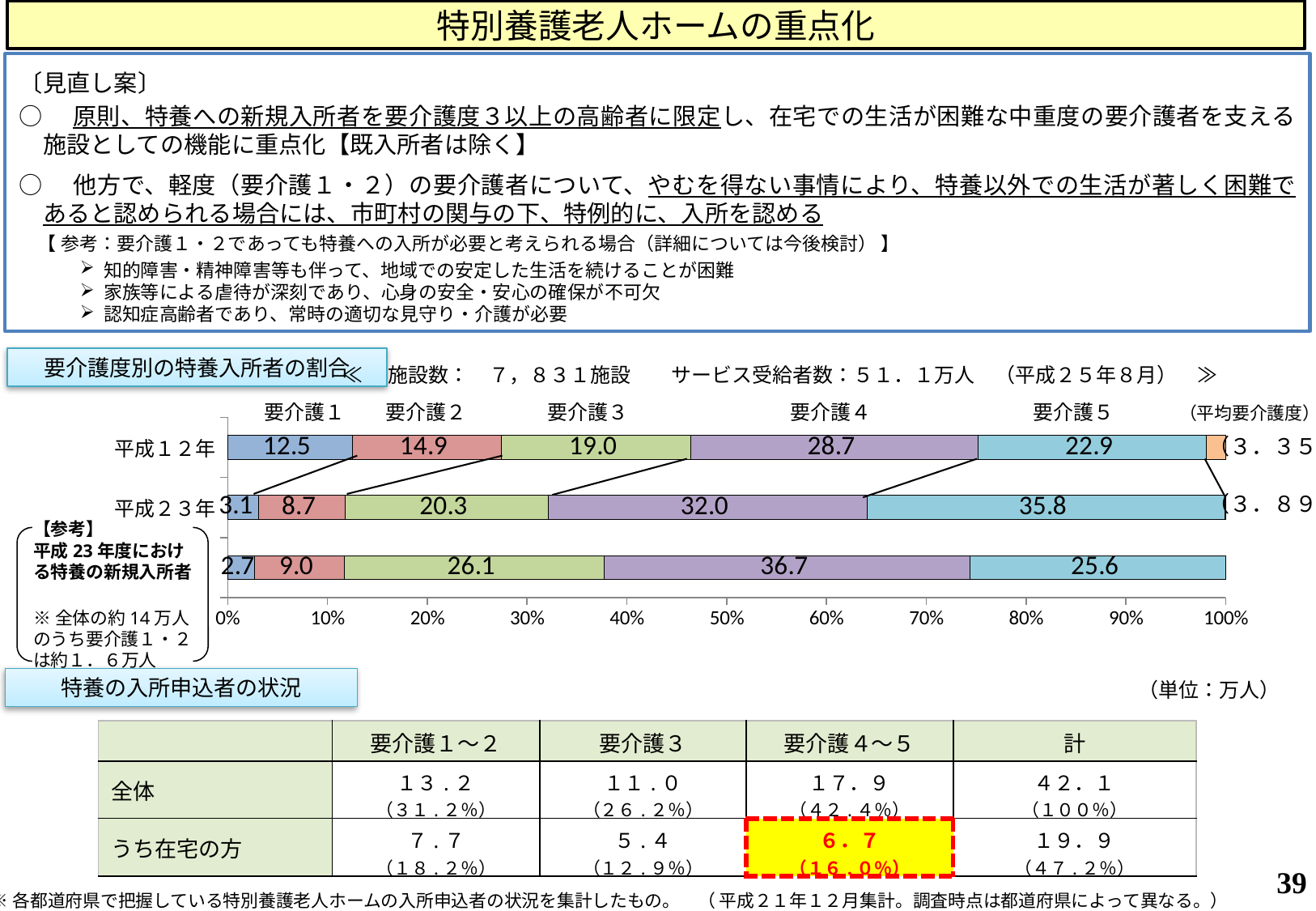
How many care-level series are shown in the 要介護度別の特養入所者の割合 chart? 5 In the 要介護度別の特養入所者の割合 chart, what is the difference between the 要介護1 value for 平成12年 and for 平成23年? 9.4 In the 要介護度別の特養入所者の割合 chart, is the 要介護4 value larger for 平成12年 or for 平成23年? 平成23年 In the 要介護度別の特養入所者の割合 chart, what is the 平均要介護度 shown for 平成23年? 3.89 How many bars are plotted in the 要介護度別の特養入所者の割合 chart? 3 In the 要介護度別の特養入所者の割合 chart, what is the value for 要介護5 in the 平成23年 bar? 35.8 In the 要介護度別の特養入所者の割合 chart, which care level has the largest share in the 平成23年 bar? 要介護5 In the 要介護度別の特養入所者の割合 chart, which care level has the smallest share in the 平成12年 bar? 要介護1 In the 要介護度別の特養入所者の割合 chart, does the 要介護5 share rise or fall from 平成12年 to 平成23年? rise In the 要介護度別の特養入所者の割合 chart, what is the value for 要介護4 in the 平成12年 bar? 28.7 What kind of chart is the 要介護度別の特養入所者の割合 chart? stacked bar chart In the 要介護度別の特養入所者の割合 chart, what is the value for 要介護3 in the bottom bar (平成23年度における特養の新規入所者)? 26.1